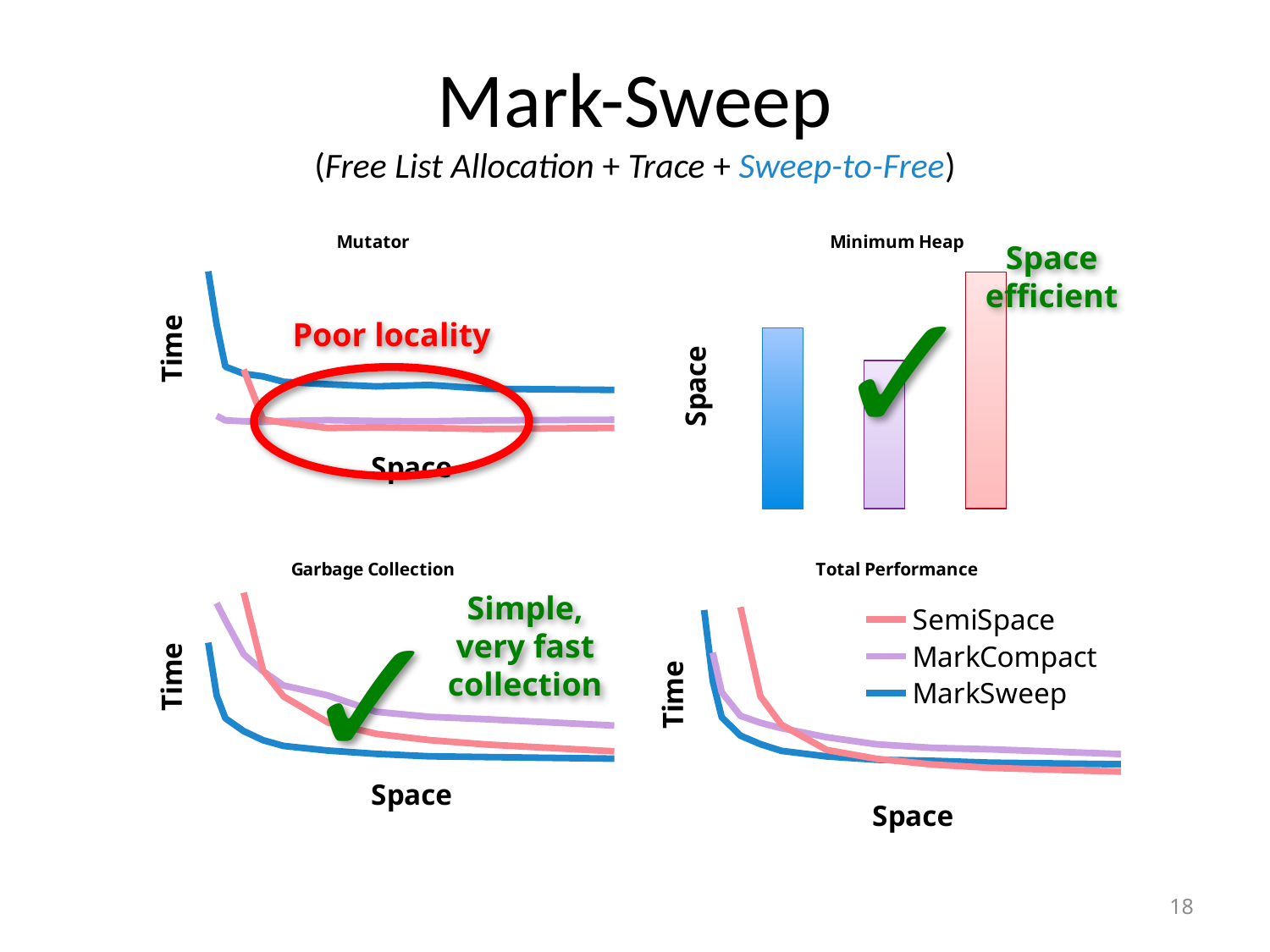
In the Garbage Collection chart, which collector has the highest time at the right end of the Space axis? MarkCompact What is the label on the vertical axis of the Minimum Heap chart? Space In the Minimum Heap chart, is the bar for MarkSweep taller or shorter than the bar for SemiSpace? shorter What kind of chart is the Total Performance chart? line chart In the Total Performance chart, do the lines rise or fall as Space increases? fall How many series does the legend on the Total Performance chart list? 3 In the Garbage Collection chart, which collector has the lowest time at the right end of the Space axis? MarkSweep In the Mutator chart, which collector has the highest time at the right end of the Space axis? MarkSweep In the Minimum Heap chart, which collector has the shortest bar? MarkCompact In the Minimum Heap chart, which collector has the tallest bar? SemiSpace How many bars are shown in the Minimum Heap chart? 3 What kind of chart is the Minimum Heap chart? bar chart